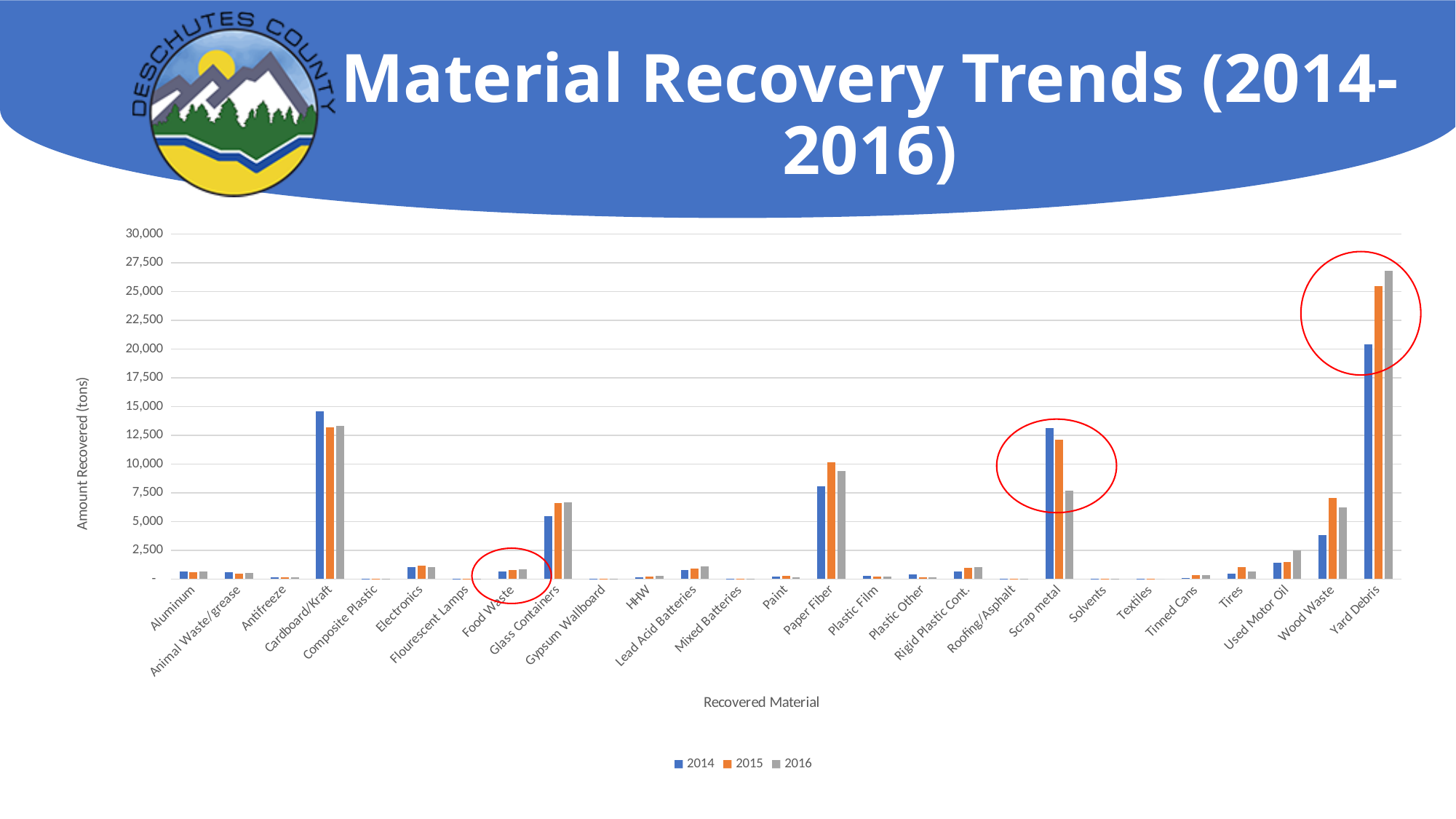
Is the 2016 value for Yard Debris greater or less than 25,000? greater For Yard Debris, which year has the larger amount recovered, 2014 or 2016? 2016 Which recovered material has the highest amount recovered in 2016? Yard Debris How many recovered material categories are shown on the x axis? 27 Is the 2016 value for Scrap metal greater or less than 10,000? less What kind of chart is shown on the slide? bar chart Is the 2014 value for Wood Waste greater or less than 2,500? greater What is the title of the vertical axis? Amount Recovered (tons) Do the Yard Debris values rise or fall from 2014 to 2016? rise How many series does the legend list? 3 For Scrap metal, which year has the larger amount recovered, 2014 or 2016? 2014